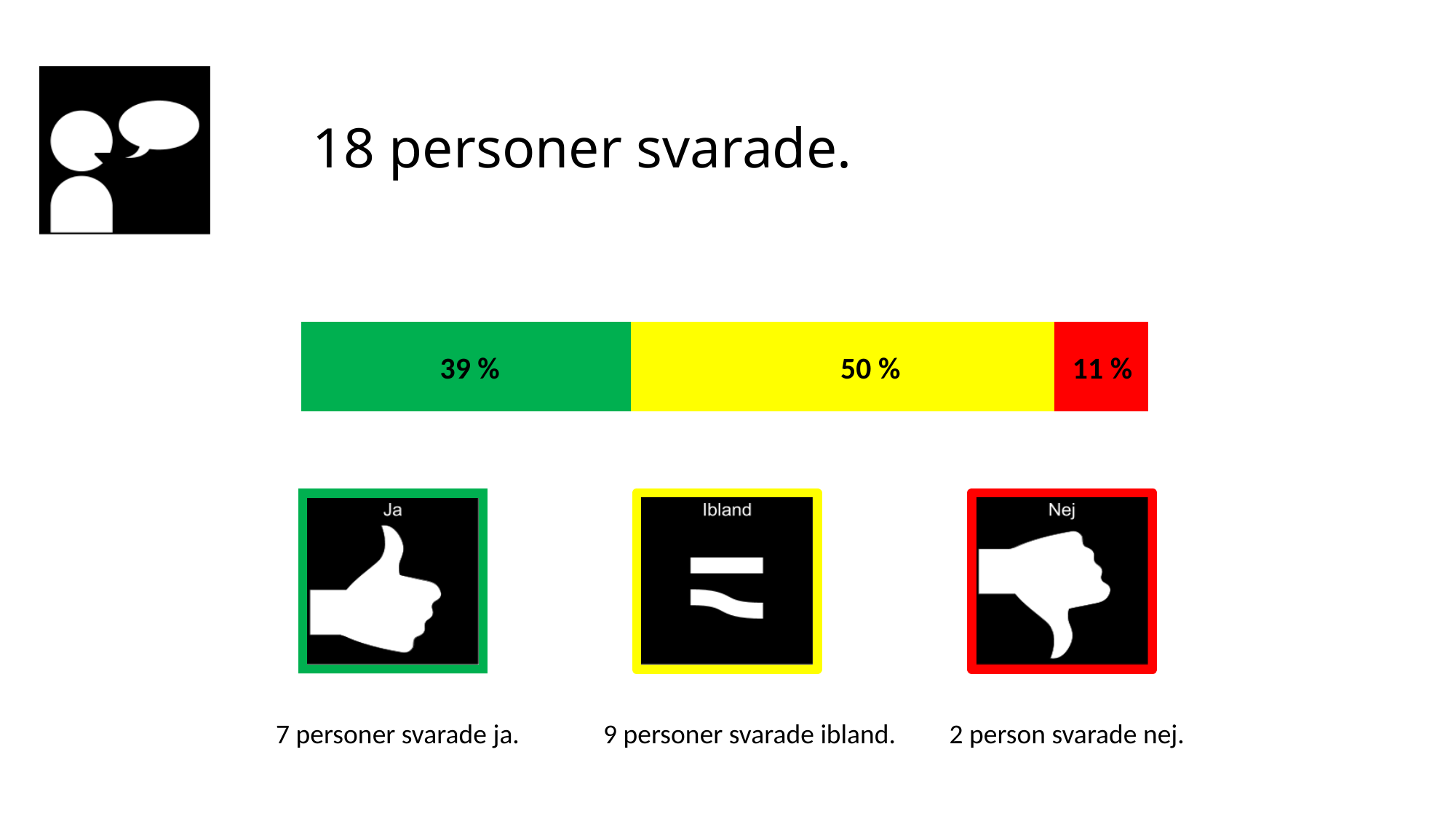
Which is larger, the share for Ja or the share for Nej? Ja What percentage is shown in the red segment of the bar? 11 % What is the difference in percentage points between the yellow (Ibland) segment and the green (Ja) segment? 11 What is the difference in percentage points between the green (Ja) segment and the red (Nej) segment? 28 How many segments does the stacked bar have? 3 What colour is the segment representing Nej? Red What percentage is shown in the yellow segment of the bar? 50 % Which response (Ja, Ibland or Nej) has the largest share of the bar? Ibland What is the total of the three percentages shown in the bar? 100 % What kind of chart is shown on the slide? Stacked bar chart What percentage is shown in the green segment of the bar? 39 % Which response (Ja, Ibland or Nej) has the smallest share of the bar? Nej